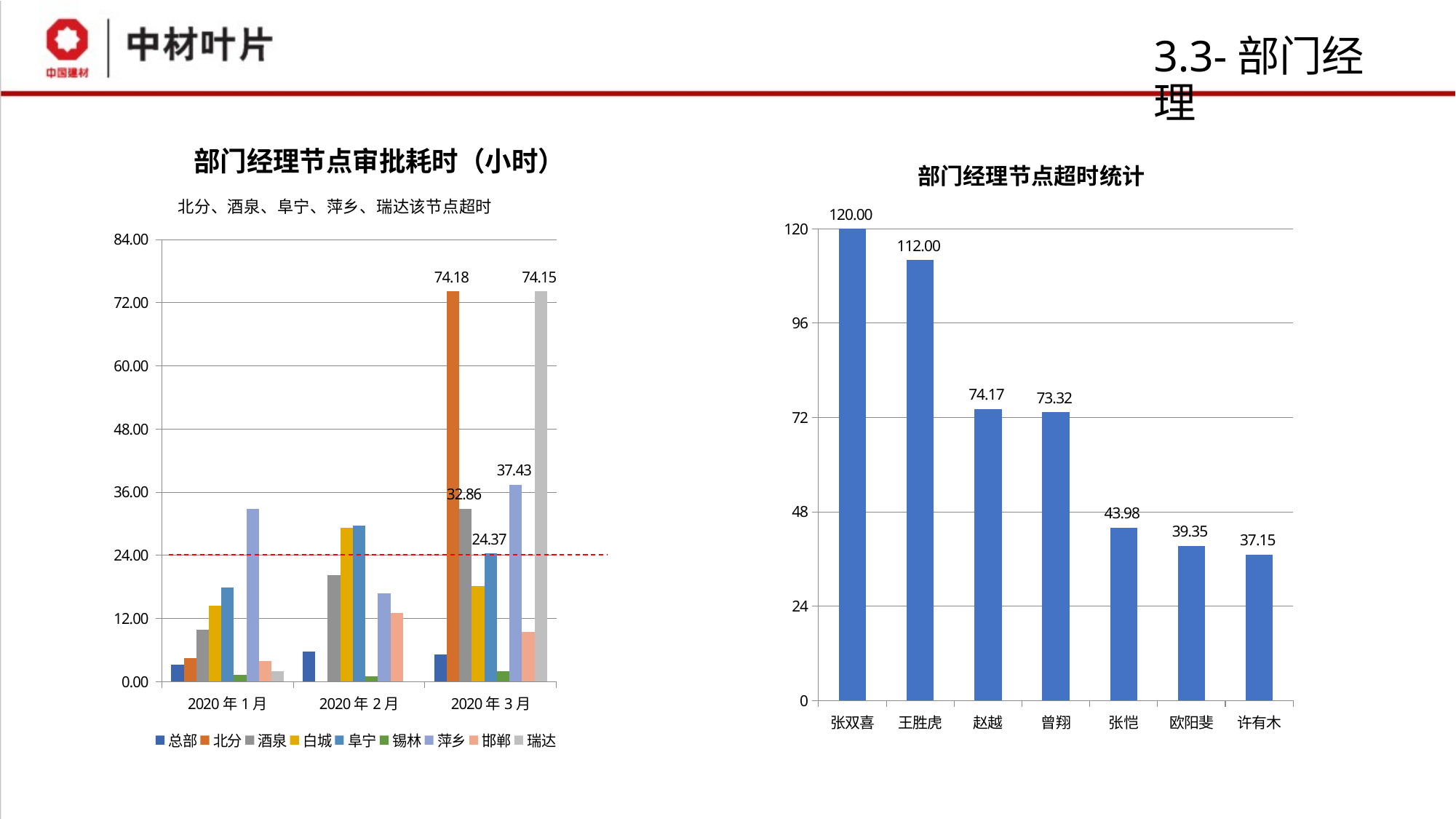
In the chart titled 部门经理节点超时统计, what is the difference between the values for 张双喜 and 王胜虎? 8.00 In the chart titled 部门经理节点超时统计, do the values rise or fall from left to right? fall In the chart titled 部门经理节点审批耗时（小时）, what is the value for 萍乡 in 2020年3月? 37.43 In the chart titled 部门经理节点审批耗时（小时）, what is the value for 北分 in 2020年3月? 74.18 What kind of chart is the chart titled 部门经理节点审批耗时（小时）? bar chart In the chart titled 部门经理节点超时统计, which person has the highest value? 张双喜 In the chart titled 部门经理节点超时统计, how many people are shown on the x axis? 7 In the chart titled 部门经理节点超时统计, which person has the lowest value? 许有木 In the chart titled 部门经理节点审批耗时（小时）, which is larger in 2020年3月: 酒泉 or 阜宁? 酒泉 In the chart titled 部门经理节点超时统计, is the value for 张恺 greater or less than 48? less In the chart titled 部门经理节点审批耗时（小时）, how many series does the legend list? 9 In the chart titled 部门经理节点超时统计, what is the value for 张双喜? 120.00